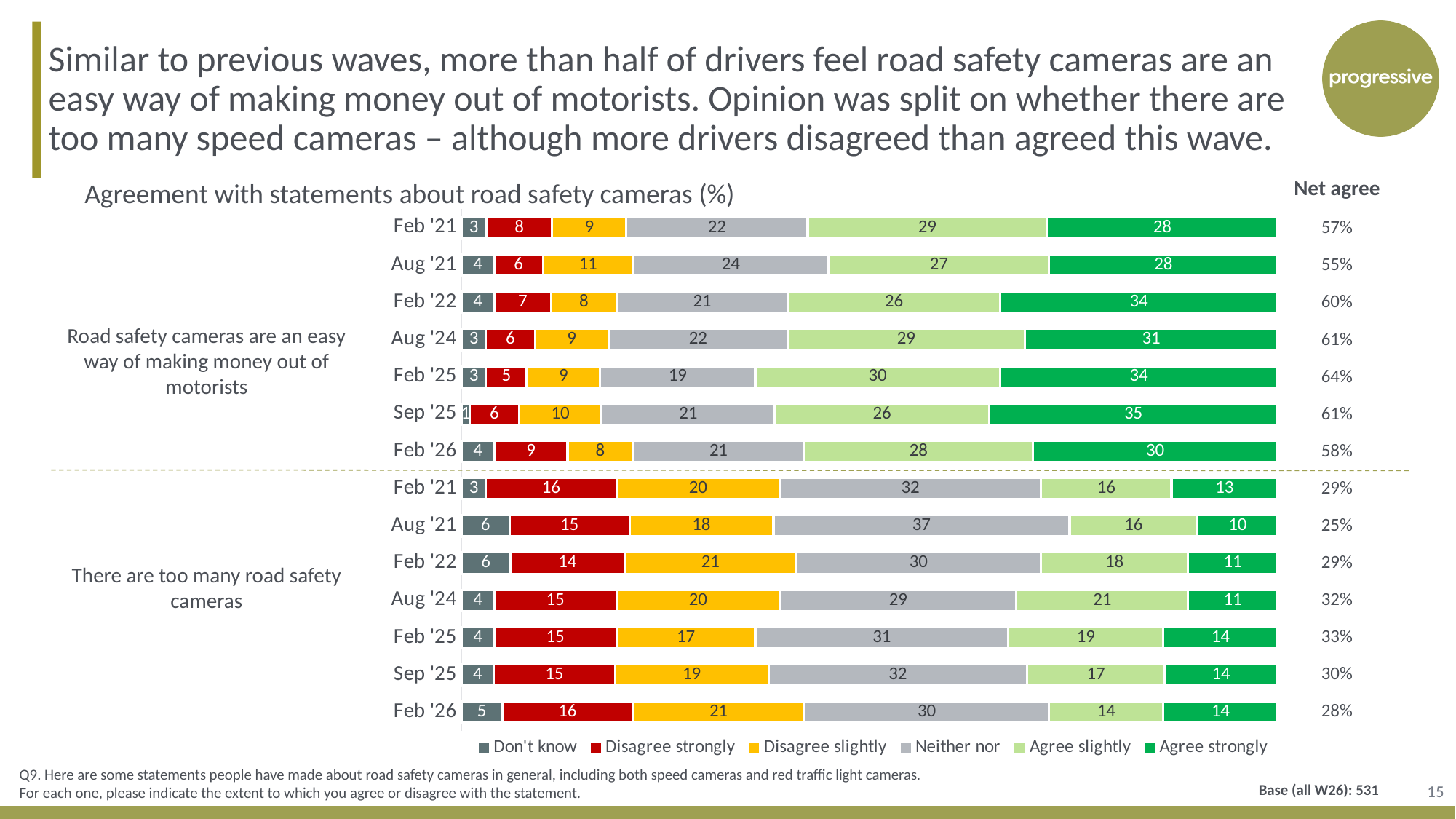
Which wave has the highest Net agree for the statement 'Road safety cameras are an easy way of making money out of motorists'? Feb '25 What is the 'Neither nor' value for Aug '21 for the statement 'There are too many road safety cameras'? 37 For the statement 'There are too many road safety cameras', what is the difference between the 'Disagree strongly' value in Feb '26 and the 'Agree strongly' value in Feb '26? 2 What kind of chart is shown on the slide? Stacked bar chart What is the total of the 'Agree slightly' and 'Agree strongly' segments for Feb '22 for the statement 'There are too many road safety cameras'? 29 Which wave has the lowest Net agree for the statement 'There are too many road safety cameras'? Aug '21 How many series does the legend list? 6 What is the Net agree figure for Feb '25 for the statement 'Road safety cameras are an easy way of making money out of motorists'? 64% How many waves (bars) are shown for each statement in the chart? 7 What is the title of the chart? Agreement with statements about road safety cameras (%) What is the 'Agree strongly' value for Feb '26 for the statement 'Road safety cameras are an easy way of making money out of motorists'? 30 For the statement 'Road safety cameras are an easy way of making money out of motorists', is the 'Agree strongly' value larger in Sep '25 or in Feb '26? Sep '25